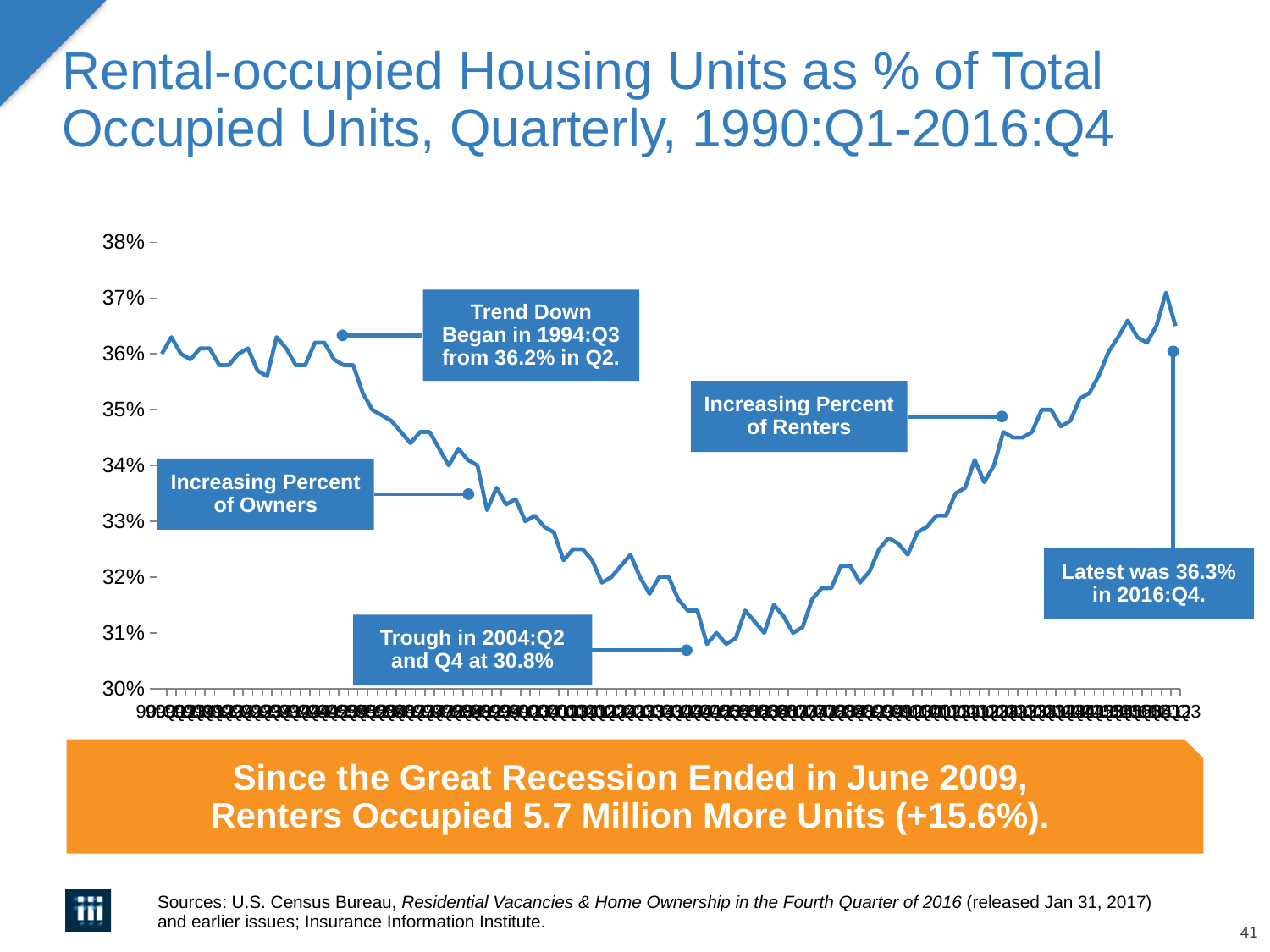
How many percentage points higher is the 1994:Q2 value (36.2%) than the 2004 trough (30.8%)? 5.4 percentage points What was the value at the trough in 2004:Q2 and Q4? 30.8% In which quarters did the series reach its trough of 30.8%? 2004:Q2 and Q4 What was the rental-occupied share in 1994:Q2, from which the downward trend began? 36.2% Which is larger: the value in 1994:Q2 or the value in 2016:Q4? 2016:Q4 Is the value at the 2004 trough greater or less than 31%? less What kind of chart is shown on the slide? Line chart Does the series rise or fall between the 2004 trough and 2016:Q4? Rises How many percentage points higher is the 2016:Q4 value (36.3%) than the 2004 trough (30.8%)? 5.5 percentage points Does the series rise or fall between 1994:Q2 and 2004:Q2? Falls What is the title of the chart? Rental-occupied Housing Units as % of Total Occupied Units, Quarterly, 1990:Q1-2016:Q4 What was the rental-occupied share of total occupied units in 2016:Q4, according to the annotation? 36.3%